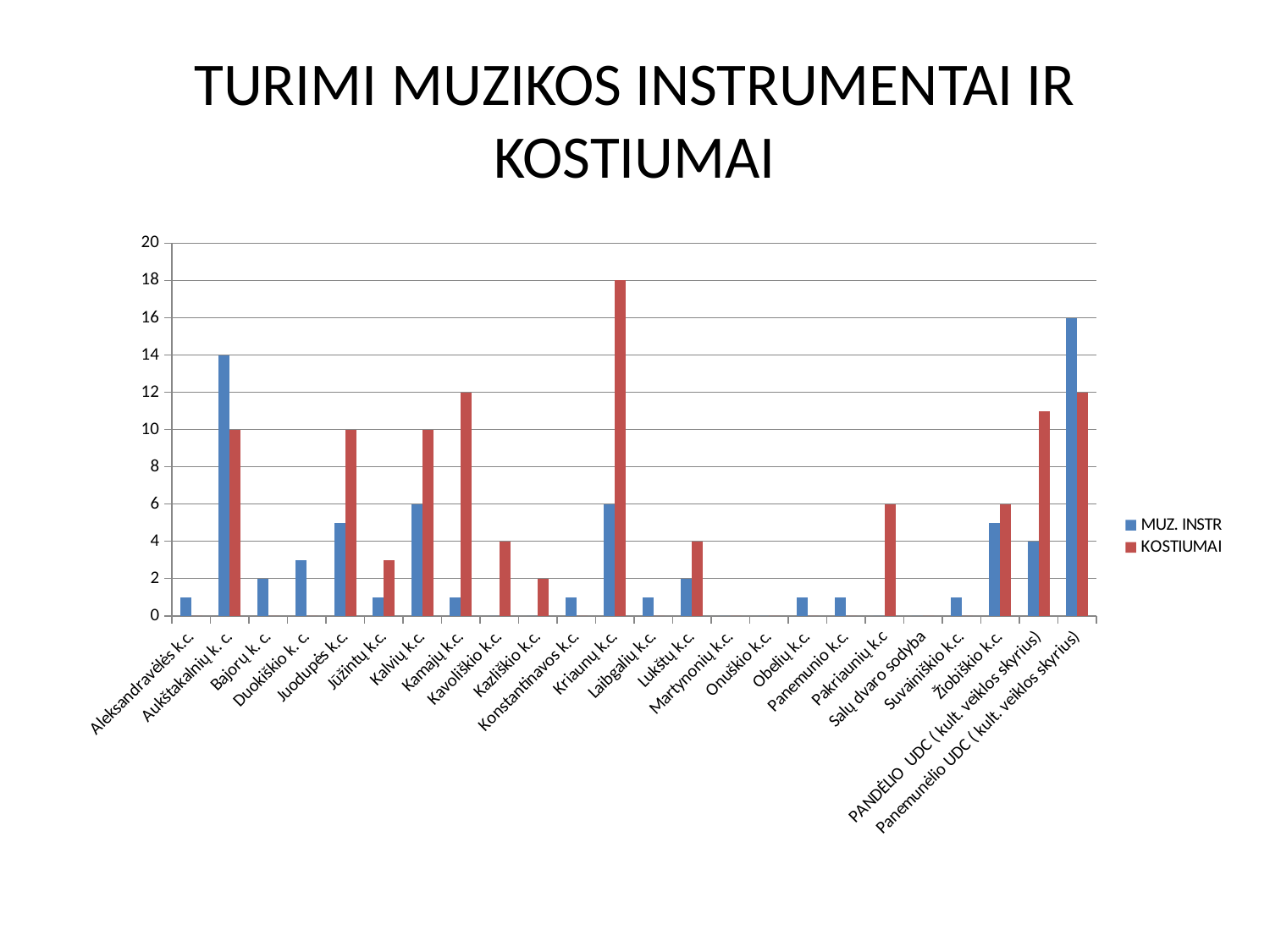
What kind of chart is shown on the slide? bar chart Is the KOSTIUMAI value for PANDĖLIO UDC ( kult. veiklos skyrius) greater or less than 10? greater What is the KOSTIUMAI value for Kriaunų k.c.? 18 Is the MUZ. INSTR value for Juodupės k.c. greater or less than 6? less What is the MUZ. INSTR value for Panemunėlio UDC ( kult. veiklos skyrius)? 16 Which category has the highest MUZ. INSTR value? Panemunėlio UDC ( kult. veiklos skyrius) How many series does the legend list? 2 What is the MUZ. INSTR value for Aukštakalnių k. c.? 14 Which is larger for Kalvių k.c.: the MUZ. INSTR value or the KOSTIUMAI value? KOSTIUMAI What is the title of the chart? TURIMI MUZIKOS INSTRUMENTAI IR KOSTIUMAI Which category has the highest KOSTIUMAI value? Kriaunų k.c. What is the difference between the KOSTIUMAI value for Kriaunų k.c. and the KOSTIUMAI value for Kamajų k.c.? 6